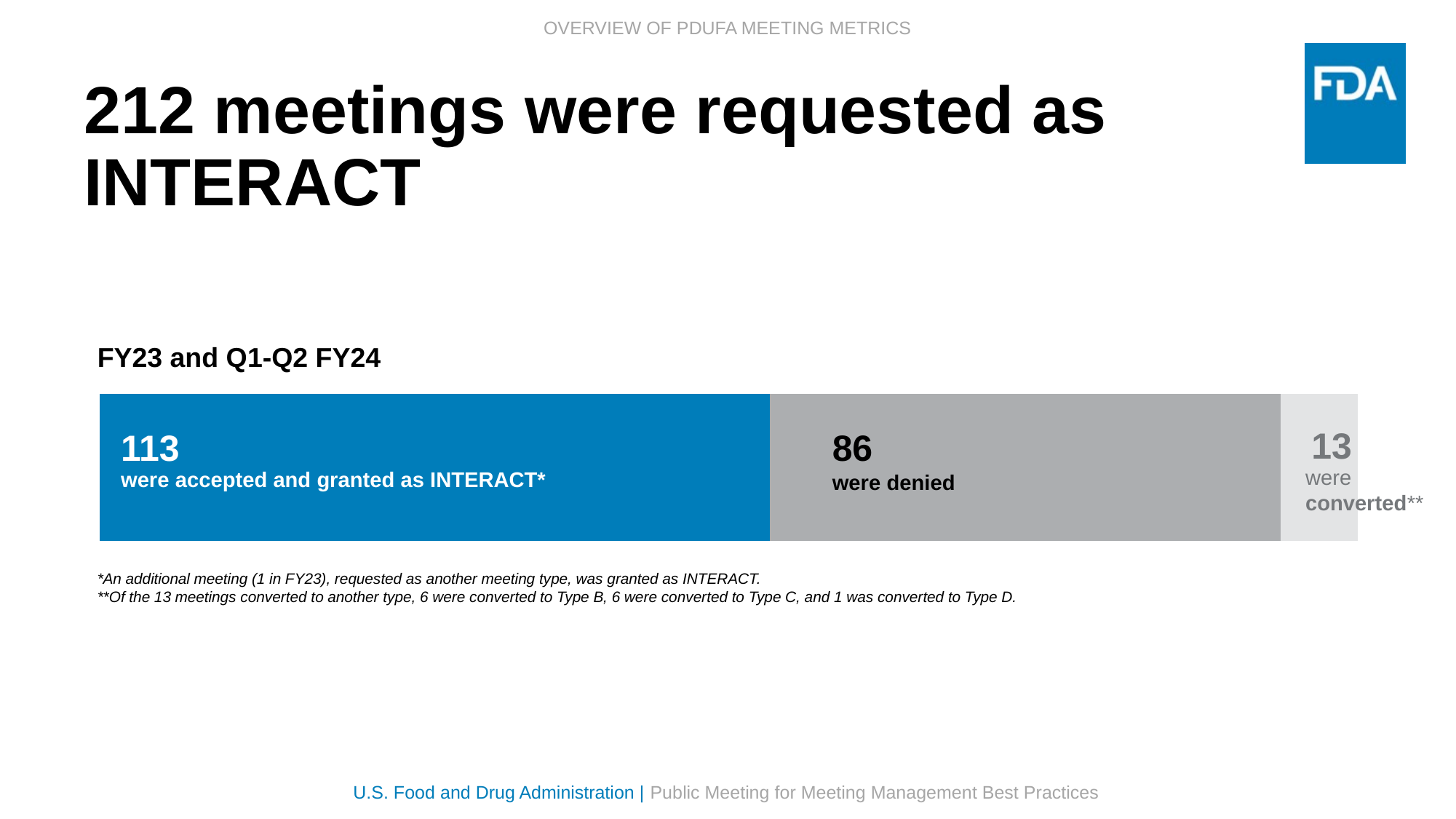
Which segment of the bar is the smallest? were converted What period does the chart cover, according to its label? FY23 and Q1-Q2 FY24 What kind of chart is shown on the slide? bar chart Which segment of the bar is the largest? were accepted and granted as INTERACT How many meetings were denied? 86 How many meetings were accepted and granted as INTERACT? 113 What is the difference between the number of meetings denied and the number converted? 73 What is the difference between the number of meetings accepted and granted as INTERACT and the number denied? 27 How many segments does the stacked bar have? 3 How many meetings were converted? 13 What is the total of all segments in the stacked bar? 212 Which is larger: the number of meetings denied or the number converted? denied